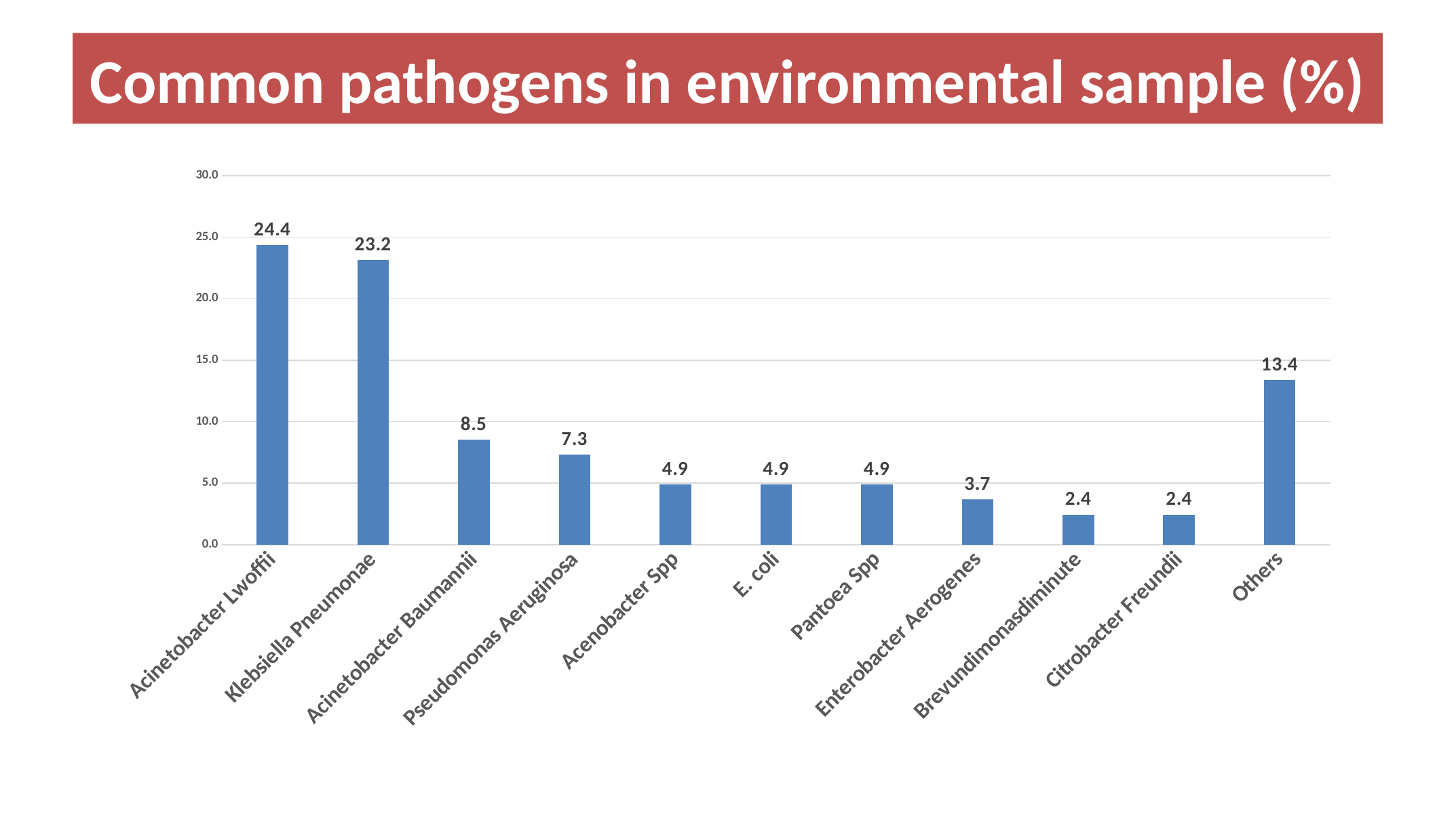
What is the value for Others? 13.4 What is the title of the slide? Common pathogens in environmental sample (%) Which pathogen has the highest value? Acinetobacter Lwoffii What is the value for Klebsiella Pneumonae? 23.2 Is the value for Others greater or less than 10.0? greater How many categories are shown on the x axis? 11 What is the difference between Acinetobacter Lwoffii and Klebsiella Pneumonae? 1.2 What kind of chart is shown on the slide? Bar chart What is the value for Enterobacter Aerogenes? 3.7 What is the difference between Acinetobacter Baumannii and Pseudomonas Aeruginosa? 1.2 Which is larger, the value for Others or the value for Acinetobacter Baumannii? Others What is the value for Acinetobacter Lwoffii? 24.4